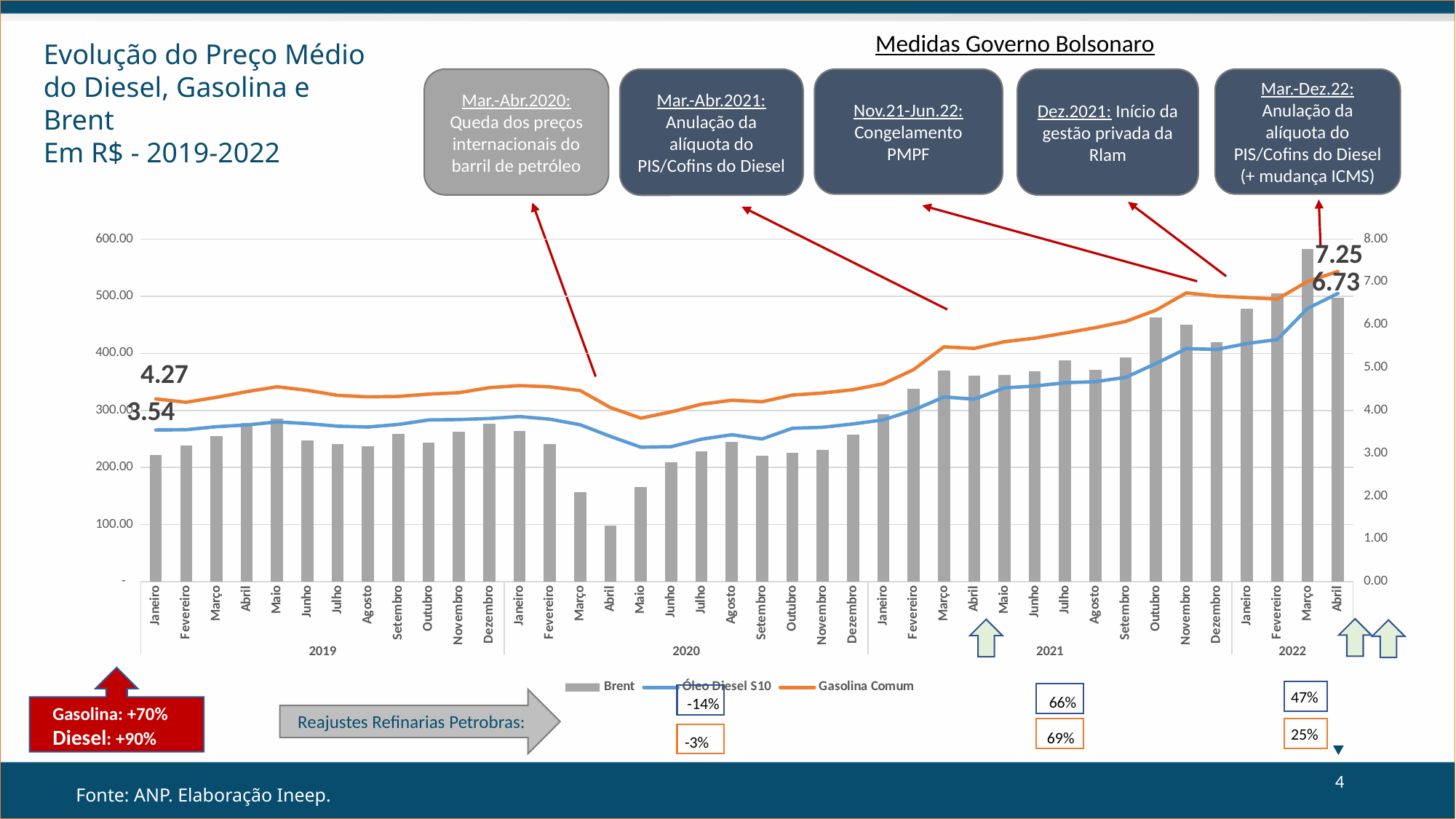
How many series does the chart legend list? 3 By how much did the labelled Gasolina Comum price rise from Janeiro 2019 (4.27) to Abril 2022 (7.25)? 2.98 In which month is the Brent bar the highest? Março 2022 What is the data label for Gasolina Comum in Janeiro 2019? 4.27 Does the Gasolina Comum line rise or fall from Janeiro 2021 to Abril 2022? rise In which month is the Brent bar the lowest? Abril 2020 What is the data label for Gasolina Comum in Abril 2022? 7.25 What kind of chart is shown on the slide? Combination bar and line chart What is the data label for Óleo Diesel S10 in Janeiro 2019? 3.54 What is the difference between the labelled Gasolina Comum (7.25) and Óleo Diesel S10 (6.73) values in Abril 2022? 0.52 What is the data label for Óleo Diesel S10 in Abril 2022? 6.73 Is the Brent value for Março 2022 greater or less than 500? greater